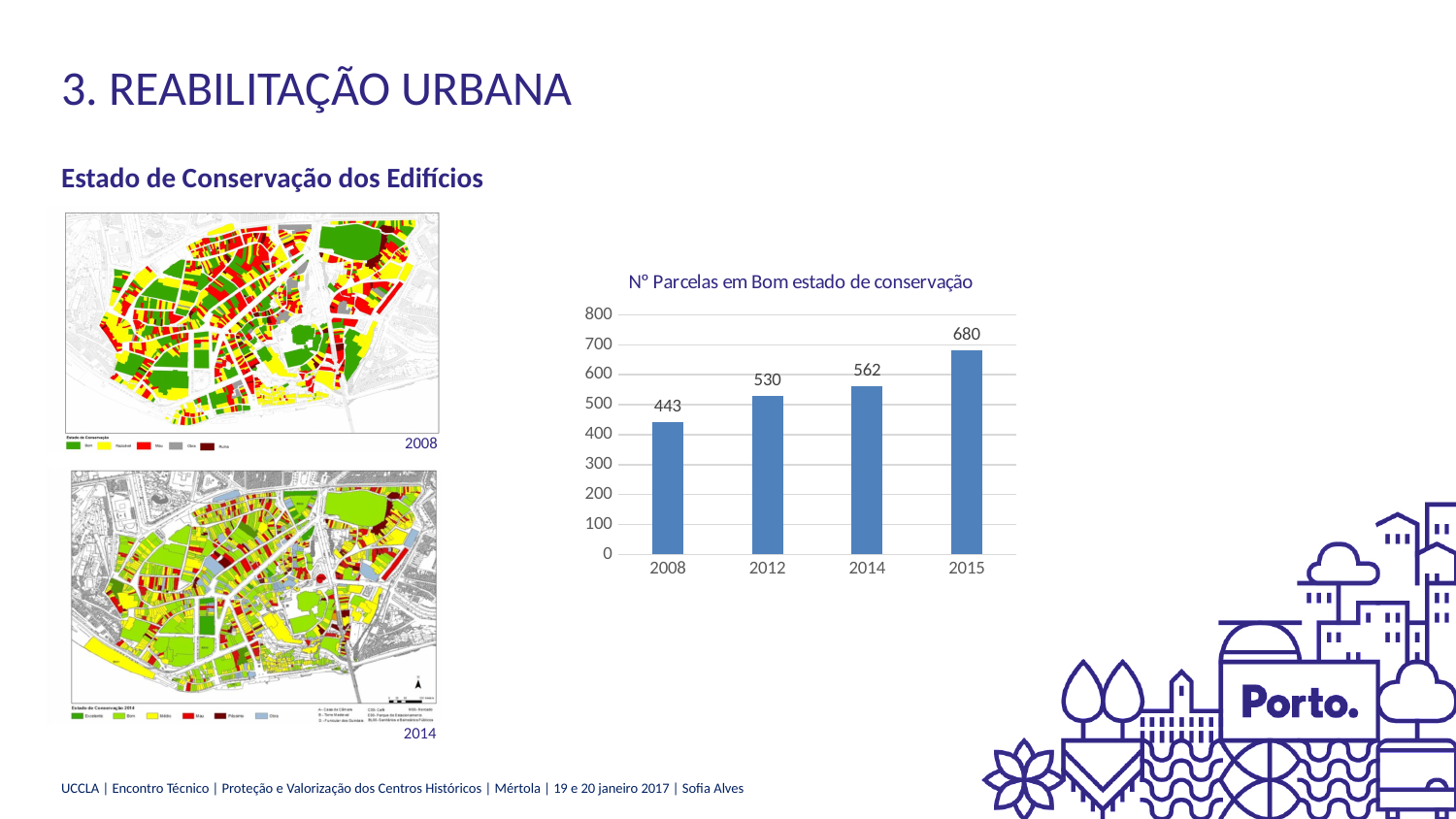
What is the value for 2015 in the chart? 680 Do the values rise or fall from 2008 to 2015? Rise Which year has the lowest number of parcels in good condition? 2008 Which year has the highest number of parcels in good condition? 2015 What is the value for 2014 in the chart? 562 What is the difference between the values for 2015 and 2008? 237 What kind of chart is shown on the slide? Bar chart What is the value for 2008 in the chart 'Nº Parcelas em Bom estado de conservação'? 443 Which is larger, the value for 2012 or the value for 2014? 2014 How many years are shown on the x axis of the chart? 4 What is the difference between the values for 2014 and 2012? 32 What is the value for 2012 in the chart? 530